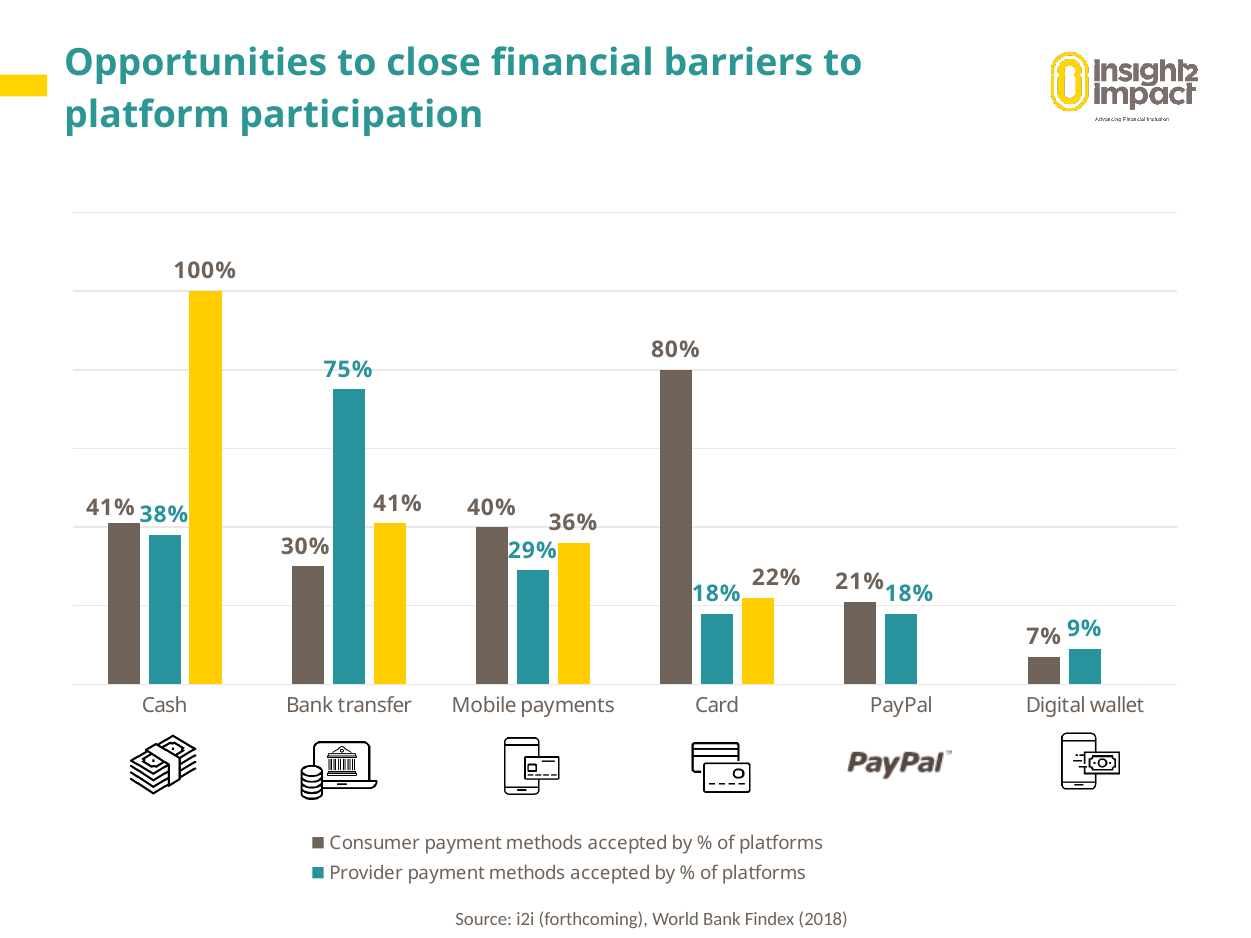
What is the value for bank transfer in the provider payment methods series? 75% What percentage of platforms accept card as a consumer payment method? 80% What is the source cited below the chart? i2i (forthcoming), World Bank Findex (2018) Which category has the lowest value in the provider payment methods series? Digital wallet How many series does the legend list? 2 What percentage of platforms accept cash as a consumer payment method? 41% What is the value of the yellow bar for cash? 100% What is the difference between the consumer and provider values for card? 62% What kind of chart is shown on the slide? Bar chart For bank transfer, which is larger: the consumer payment methods value or the provider payment methods value? Provider payment methods Which category has the highest value in the consumer payment methods series? Card How many payment method categories are shown on the x axis? 6